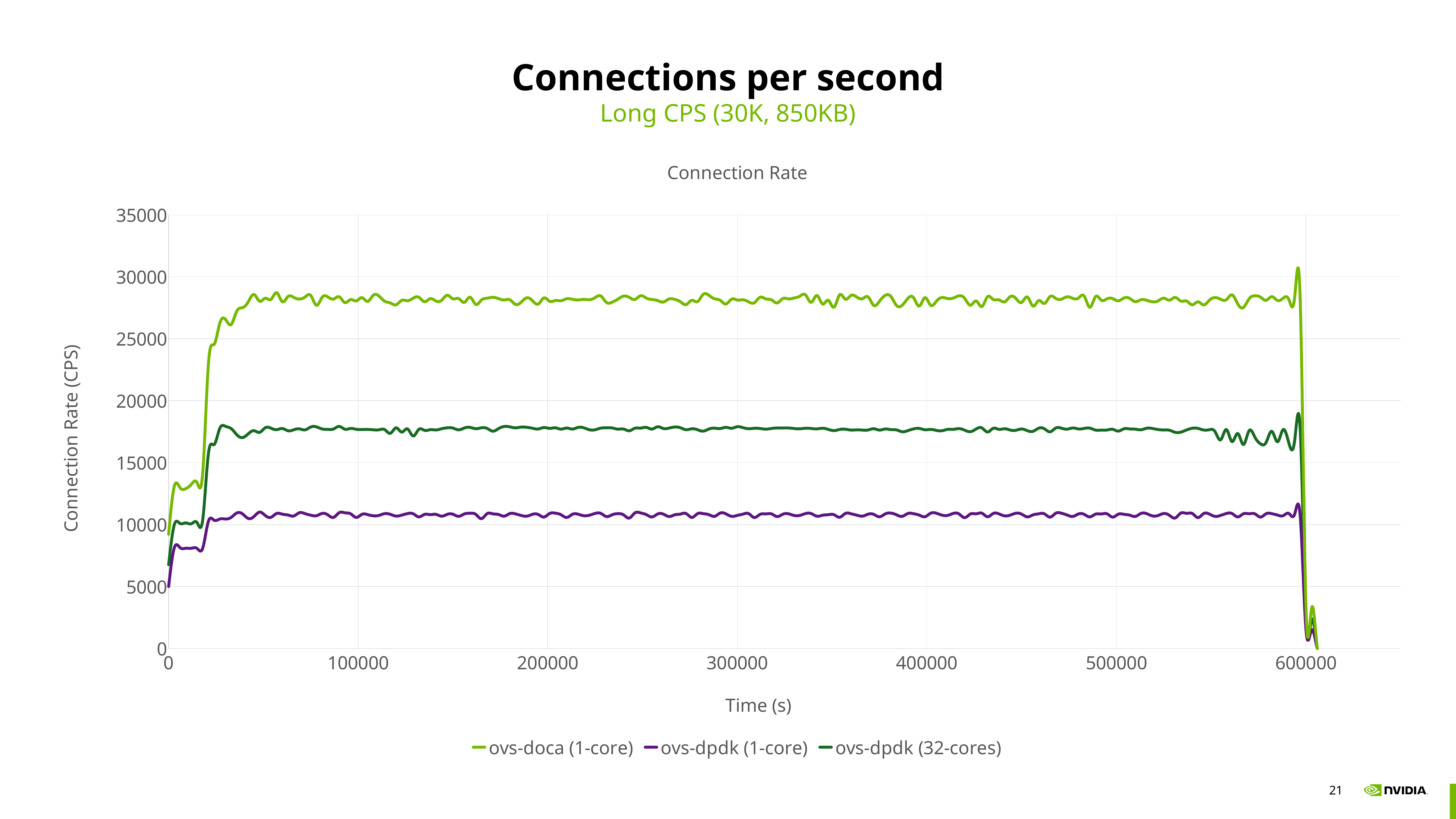
Is the value for ovs-doca (1-core) at 100000 s greater or less than 30000? less Is the value for ovs-doca (1-core) at 300000 s greater or less than 25000? greater Which series has the lowest connection rate during the steady-state portion of the test? ovs-dpdk (1-core) What is the label of the x axis? Time (s) Is the value for ovs-dpdk (1-core) at 300000 s greater or less than 15000? less At 300000 s, which is larger: ovs-dpdk (32-cores) or ovs-dpdk (1-core)? ovs-dpdk (32-cores) What kind of chart is shown on the slide? line chart How many series does the legend list? 3 Which series has the highest connection rate during the steady-state portion of the test? ovs-doca (1-core) Does the ovs-doca (1-core) line rise or fall between 0 and 50000 s? rise What is the title printed above the plot area? Connection Rate